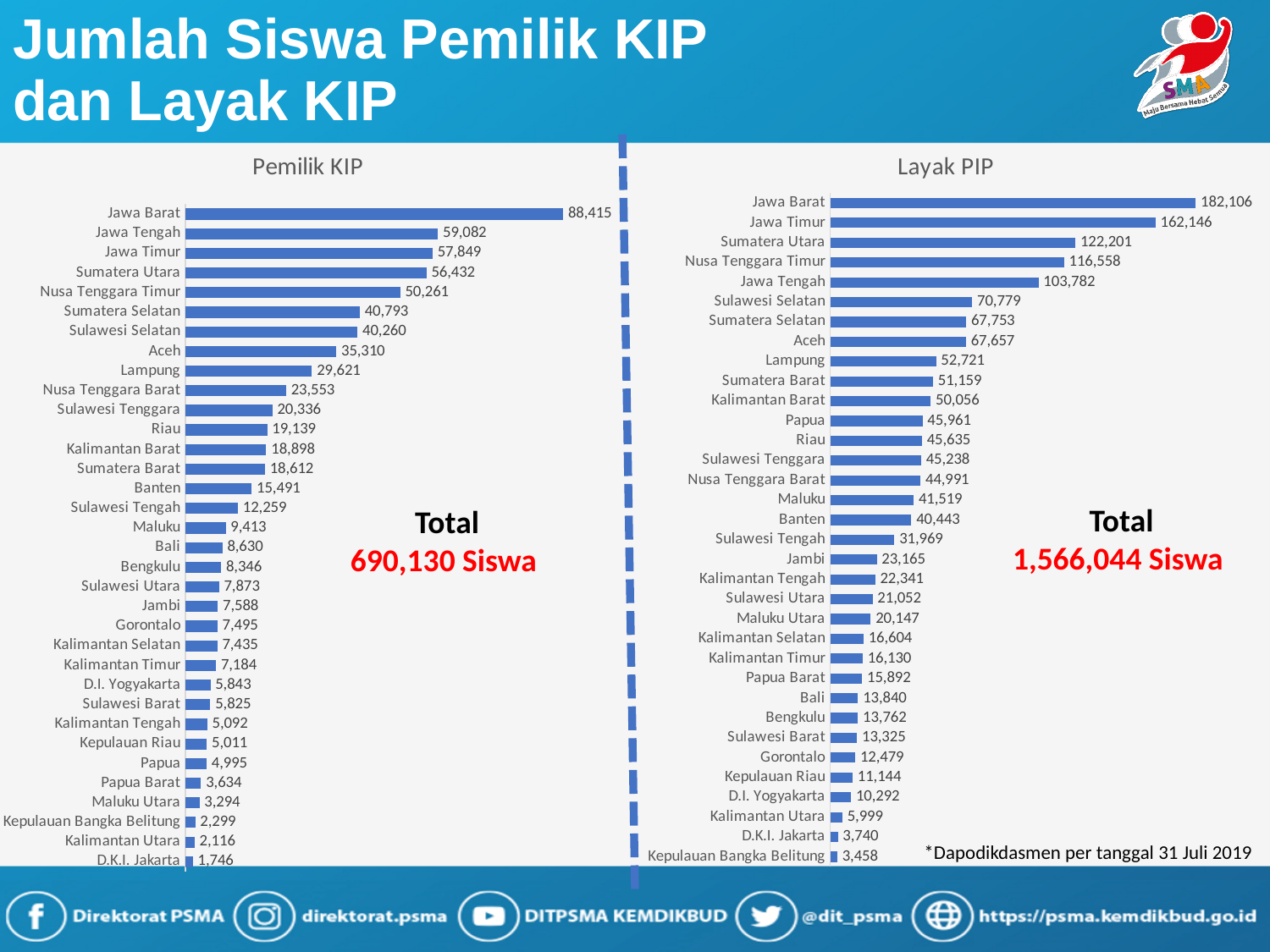
In the Layak PIP chart, which is larger, Bali or Papua Barat? Papua Barat In the Layak PIP chart, what is the difference between Jawa Barat and Jawa Timur? 19,960 In the Pemilik KIP chart, what is the difference between Jawa Barat and Jawa Tengah? 29,333 In the Pemilik KIP chart, which province has the lowest value? D.K.I. Jakarta In the Pemilik KIP chart, which is larger, Aceh or Lampung? Aceh In the Layak PIP chart, what is the value for Sumatera Utara? 122,201 In the Pemilik KIP chart, what is the value for Jawa Barat? 88,415 What total is shown next to the Layak PIP chart? 1,566,044 Siswa How many provinces are shown in the Pemilik KIP chart? 34 In the Layak PIP chart, which province has the lowest value? Kepulauan Bangka Belitung What kind of chart is the Layak PIP chart? Bar chart In the Layak PIP chart, which province has the highest value? Jawa Barat